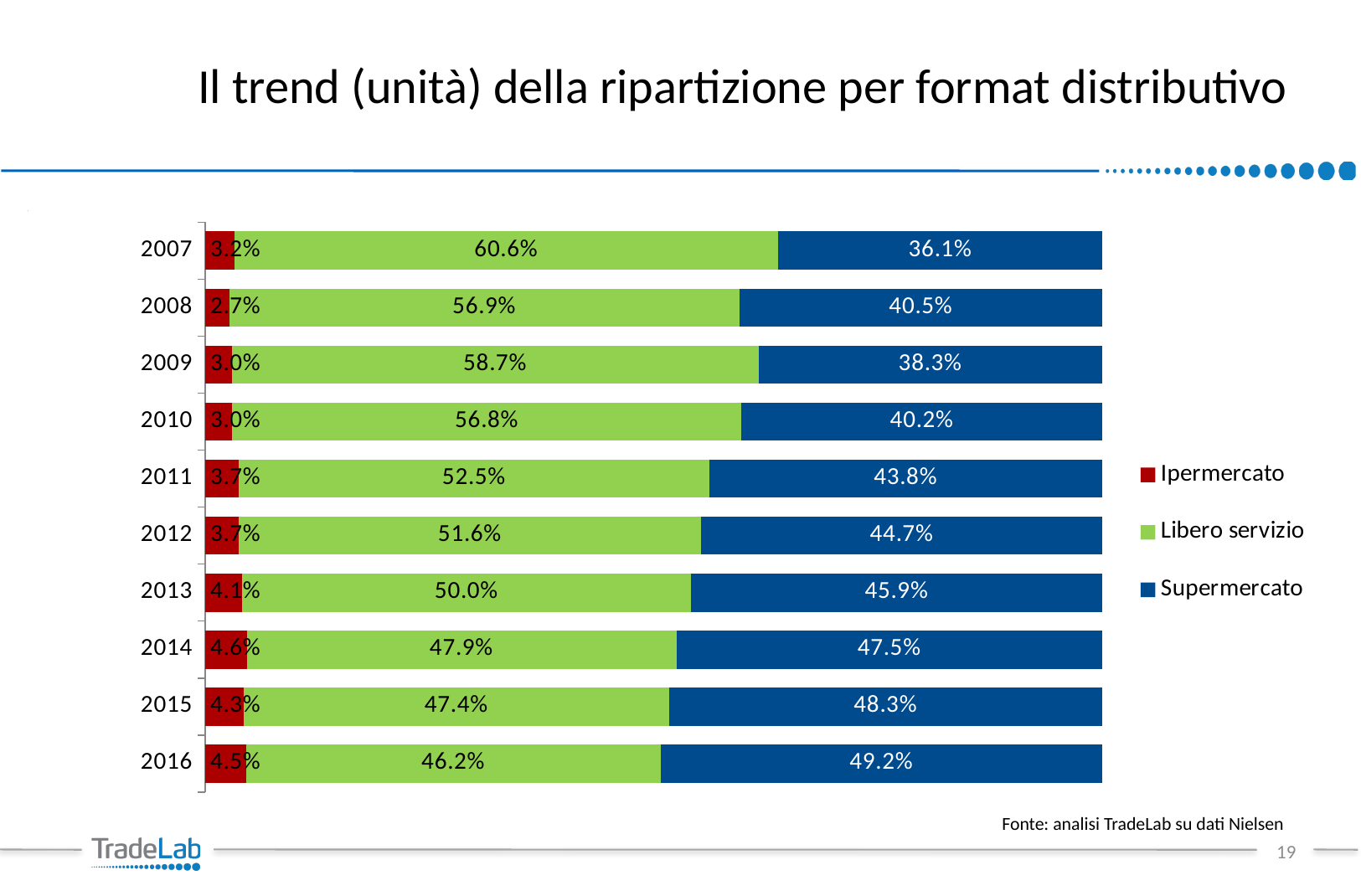
How many series does the legend list? 3 What is the total of the three segments for 2013? 100.0% What is the Supermercato value for 2007? 36.1% How many years are shown on the chart? 10 What is the Ipermercato value for 2014? 4.6% By how many percentage points did the Supermercato share grow from 2007 to 2016? 13.1 percentage points Does the Libero servizio share rise or fall from 2007 to 2016? Fall What is the Libero servizio value for 2016? 46.2% In which year is the Ipermercato share lowest? 2008 In 2014, which is larger: Libero servizio or Supermercato? Libero servizio In which year is the Libero servizio share highest? 2007 What kind of chart is shown on the slide? Stacked bar chart